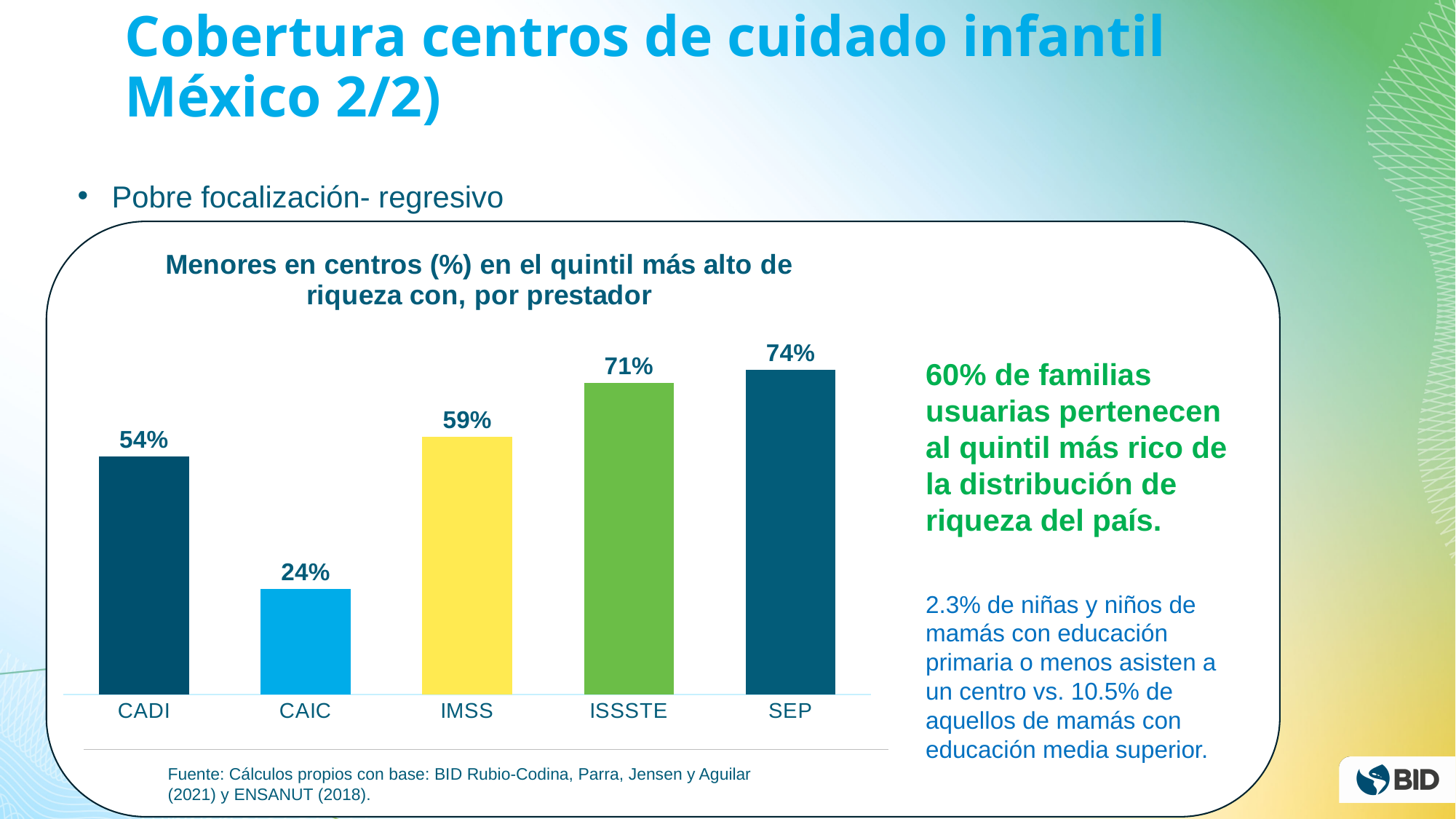
What is the value for SEP? 74% What is the title of the chart? Menores en centros (%) en el quintil más alto de riqueza con, por prestador What colour is the bar for IMSS? Yellow What is the difference between the values for SEP and CADI? 20% What is the value for CAIC? 24% Which category has the highest value? SEP What is the value for IMSS? 59% Which is larger, the value for CADI or the value for IMSS? IMSS What kind of chart is shown on the slide? Bar chart How many categories are shown on the x axis? 5 What is the difference between the values for ISSSTE and CAIC? 47% Which category has the lowest value? CAIC